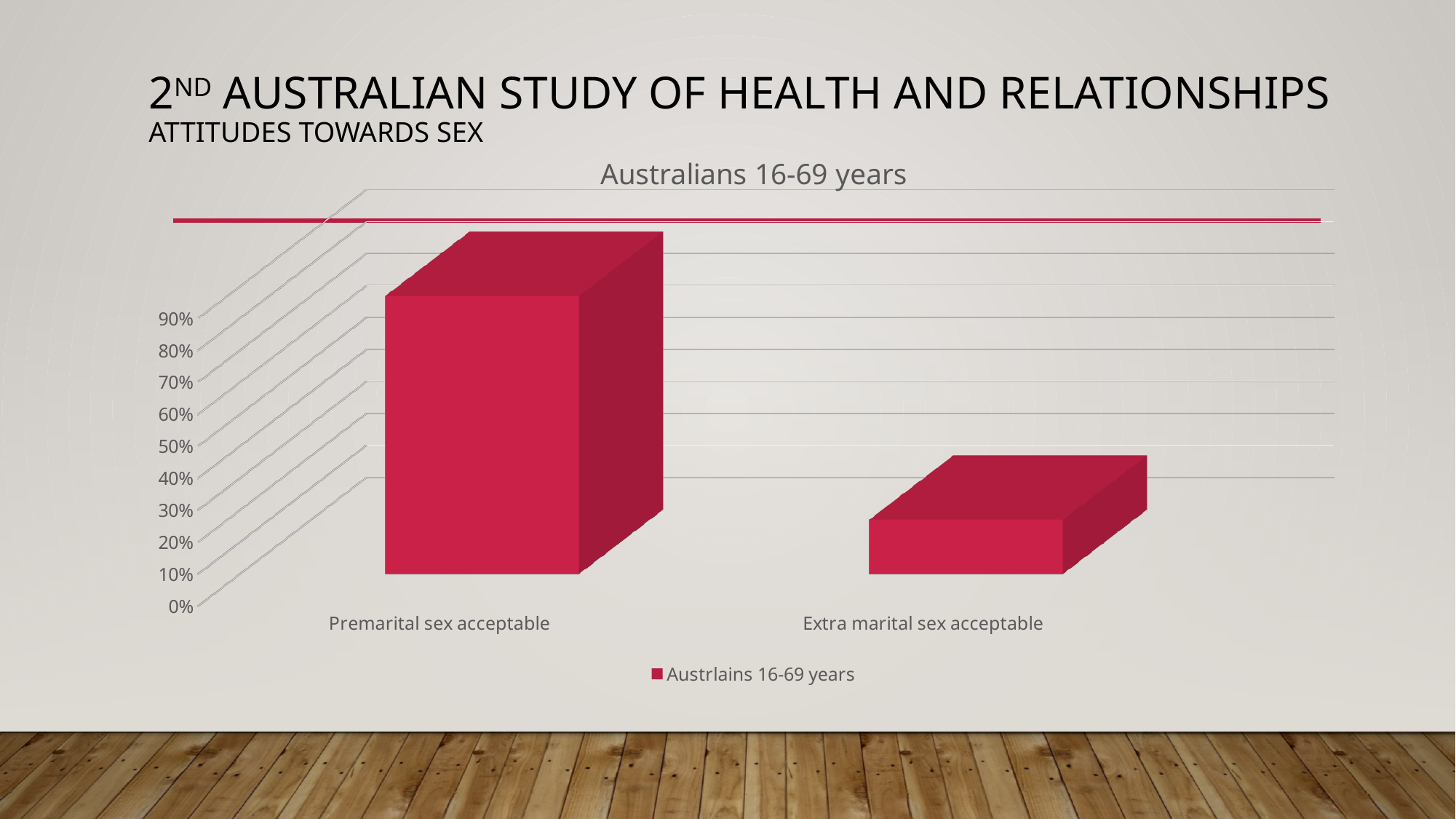
Is the value for Extra marital sex acceptable greater or less than 40%? less Which category has the highest value? Premarital sex acceptable Is the value for Premarital sex acceptable greater or less than 50%? greater Which category has the lowest value? Extra marital sex acceptable What is the title of the chart? Australians 16-69 years How many series does the legend list? 1 How many categories are plotted in the chart? 2 Which is larger, the value for Premarital sex acceptable or the value for Extra marital sex acceptable? Premarital sex acceptable Is the value for Extra marital sex acceptable greater or less than 50%? less What kind of chart is shown on the slide? bar chart Do the values rise or fall from the left category to the right category? fall What colour are the bars in the chart? red